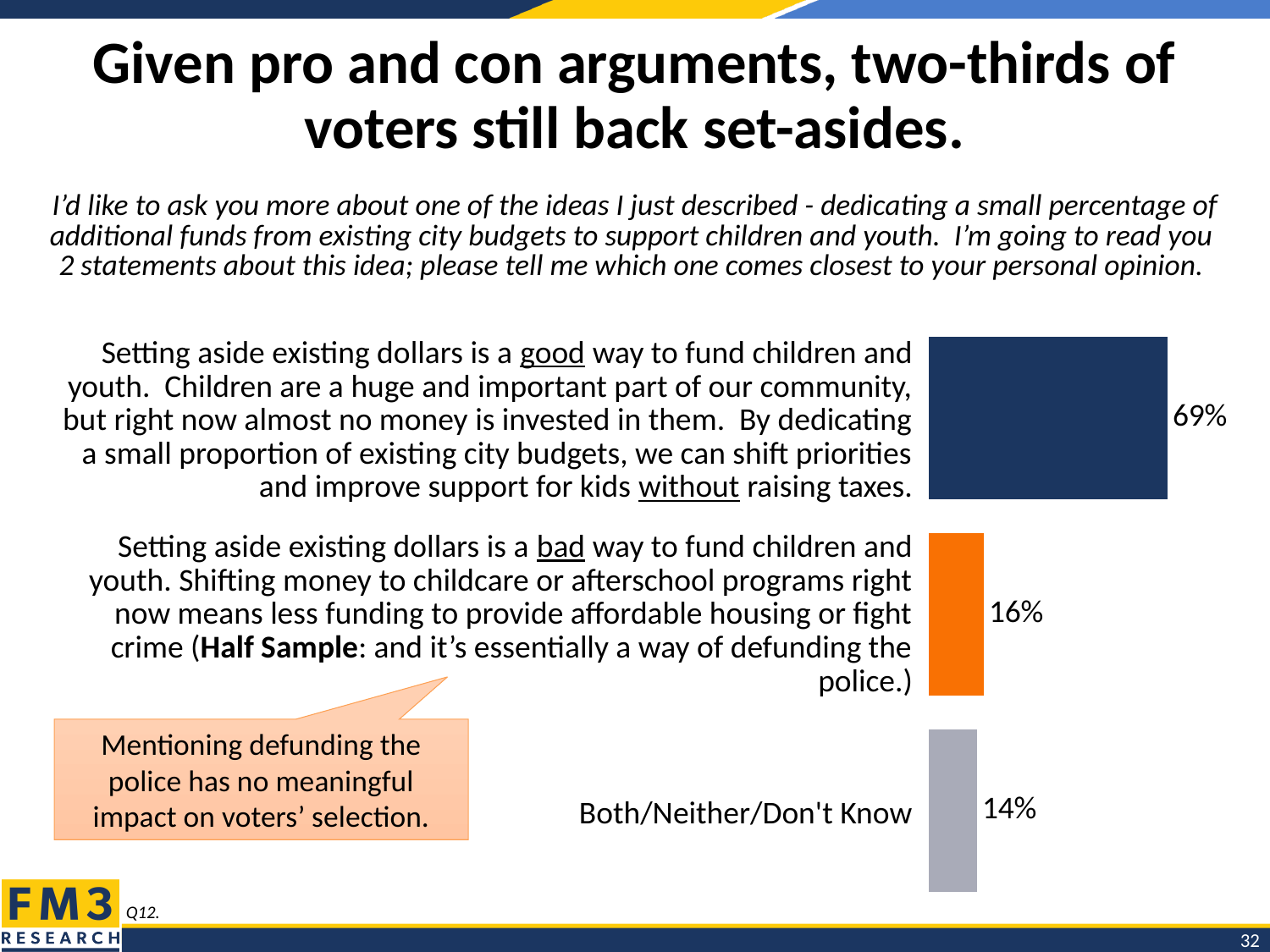
What is the difference in percentage points between the 'good way' statement and the 'bad way' statement? 53 Which response category has the highest value? Setting aside existing dollars is a good way to fund children and youth What colour is the bar for the 'bad way' statement? Orange What is the difference in percentage points between the 'bad way' statement and Both/Neither/Don't Know? 2 What percentage of voters chose the statement that setting aside existing dollars is a bad way to fund children and youth? 16% What type of chart is shown on the slide? Bar chart What percentage of voters answered Both/Neither/Don't Know? 14% How many response categories are shown in the chart? 3 Which is larger: the share choosing the 'bad way' statement or the share answering Both/Neither/Don't Know? The 'bad way' statement Which response category has the lowest value? Both/Neither/Don't Know What percentage of voters chose the statement that setting aside existing dollars is a good way to fund children and youth? 69% What colour is the bar for Both/Neither/Don't Know? Gray